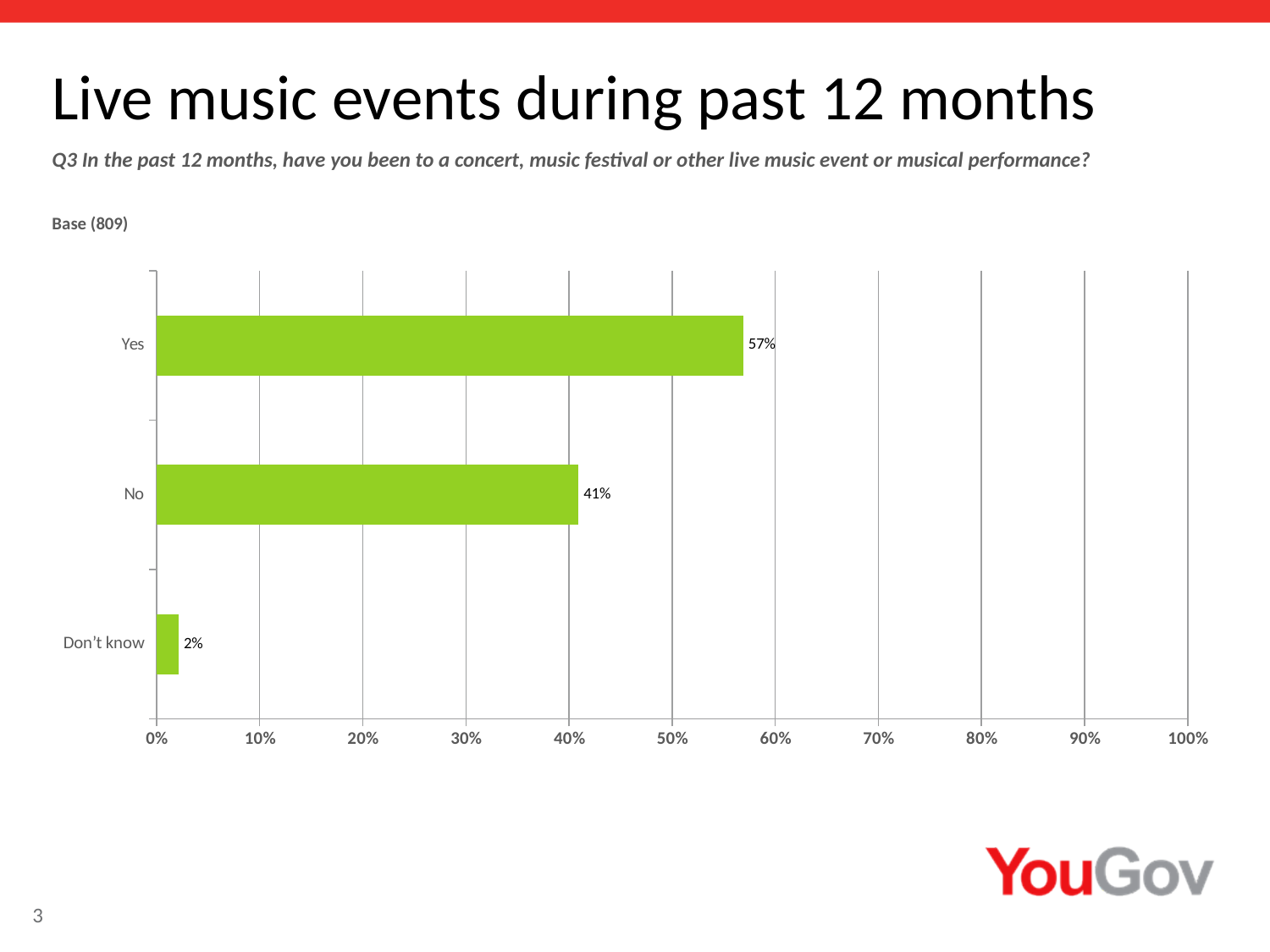
Which is larger, the value for "No" or the value for "Don't know"? No What percentage of respondents answered "Don't know"? 2% Is the value for "Yes" greater or less than 50%? greater What is the title of the slide? Live music events during past 12 months Which response category has the highest value? Yes What kind of chart is shown on the slide? Bar chart What percentage of respondents answered "Yes"? 57% How many response categories are shown in the chart? 3 What is the difference between the "Yes" and "No" percentages? 16% What is the base (number of respondents) stated on the slide? 809 What percentage of respondents answered "No"? 41% Which response category has the lowest value? Don't know